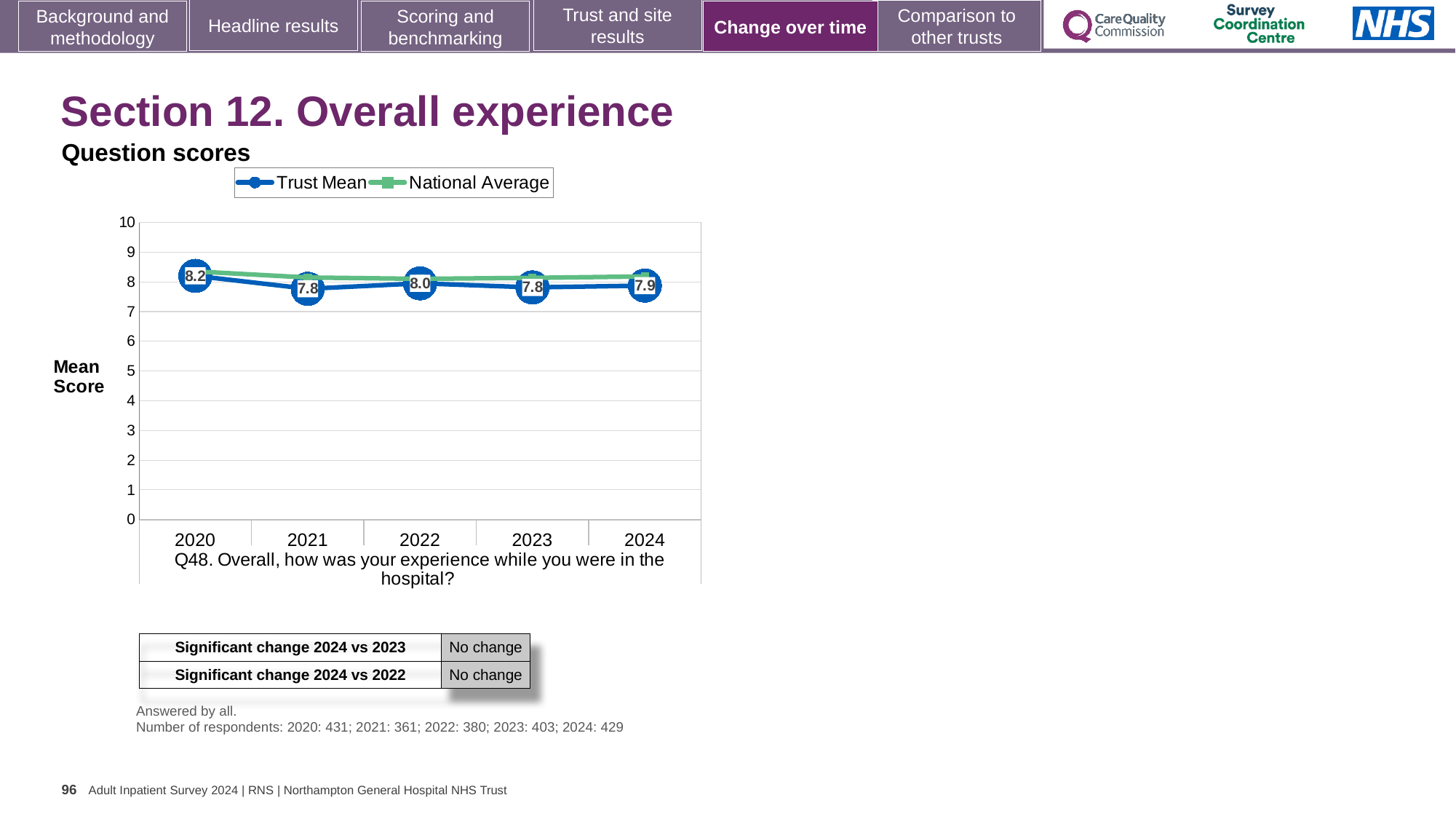
What is the difference between the Trust Mean scores for 2020 and 2021? 0.4 What is the Trust Mean score for 2020? 8.2 What is the label of the y axis? Mean Score In which year is the Trust Mean score highest? 2020 Which year has the larger Trust Mean score, 2022 or 2023? 2022 How many series does the legend list? 2 How many years are plotted on the x axis? 5 What is the Trust Mean score for 2024? 7.9 What kind of chart is shown? line chart Does the Trust Mean score rise or fall from 2020 to 2024? fall Is the National Average value for 2020 greater or less than 8? greater What is the Trust Mean score for 2022? 8.0